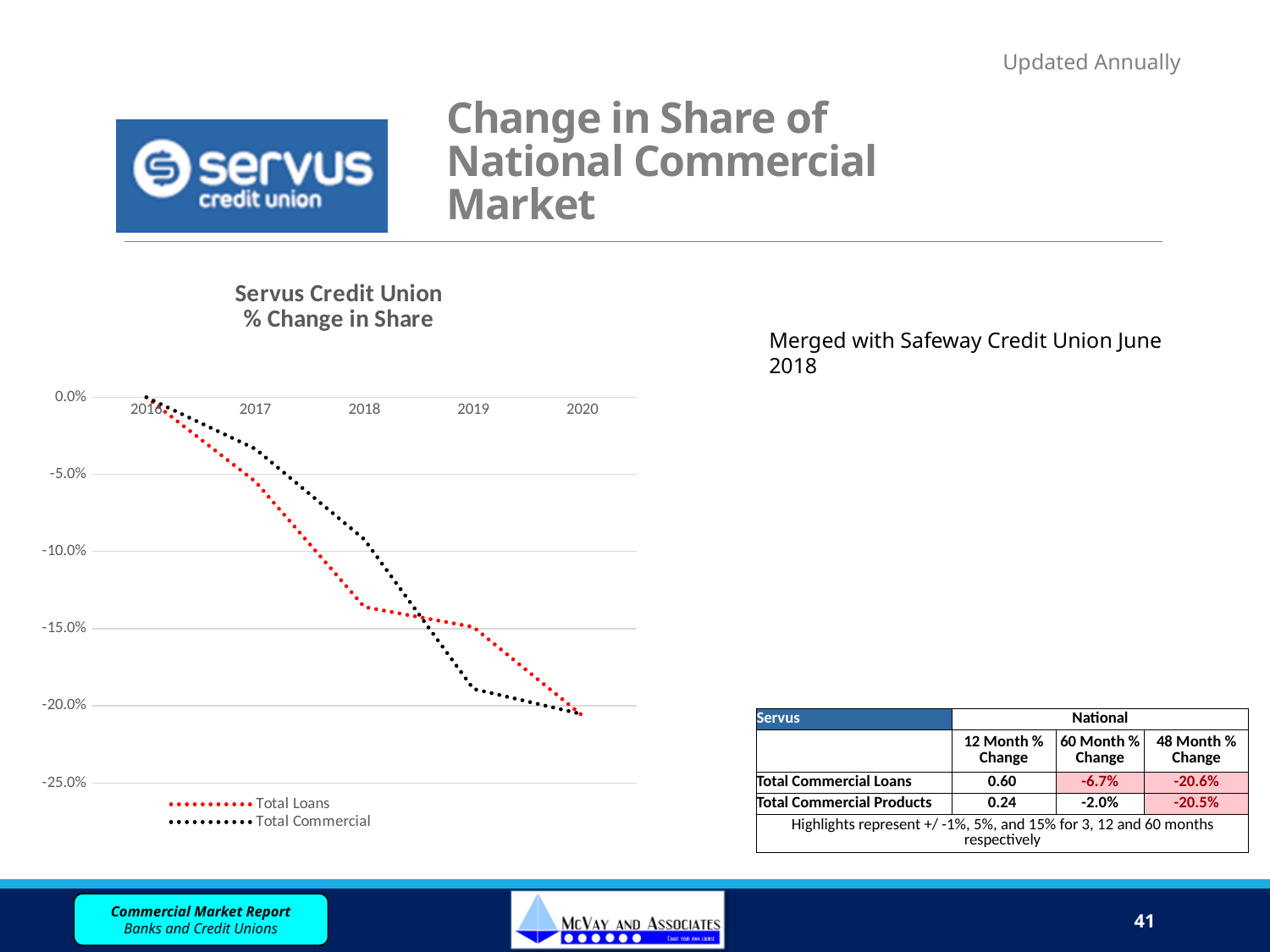
In 2019, which series has the lower value, Total Loans or Total Commercial? Total Commercial Is the value for Total Loans in 2018 greater or less than -10.0%? less Is the value for Total Commercial in 2019 greater or less than -20.0%? greater Which colour is used for the Total Loans series in the chart? Red How many series does the chart legend list? 2 How many years are shown along the x axis of the chart? 5 Is the value for Total Loans in 2020 greater or less than -20.0%? less In 2018, which series has the lower value, Total Loans or Total Commercial? Total Loans What is the title of the chart? Servus Credit Union % Change in Share What kind of chart is shown on the slide? Line chart Do the values in the chart rise or fall from 2016 to 2020? Fall